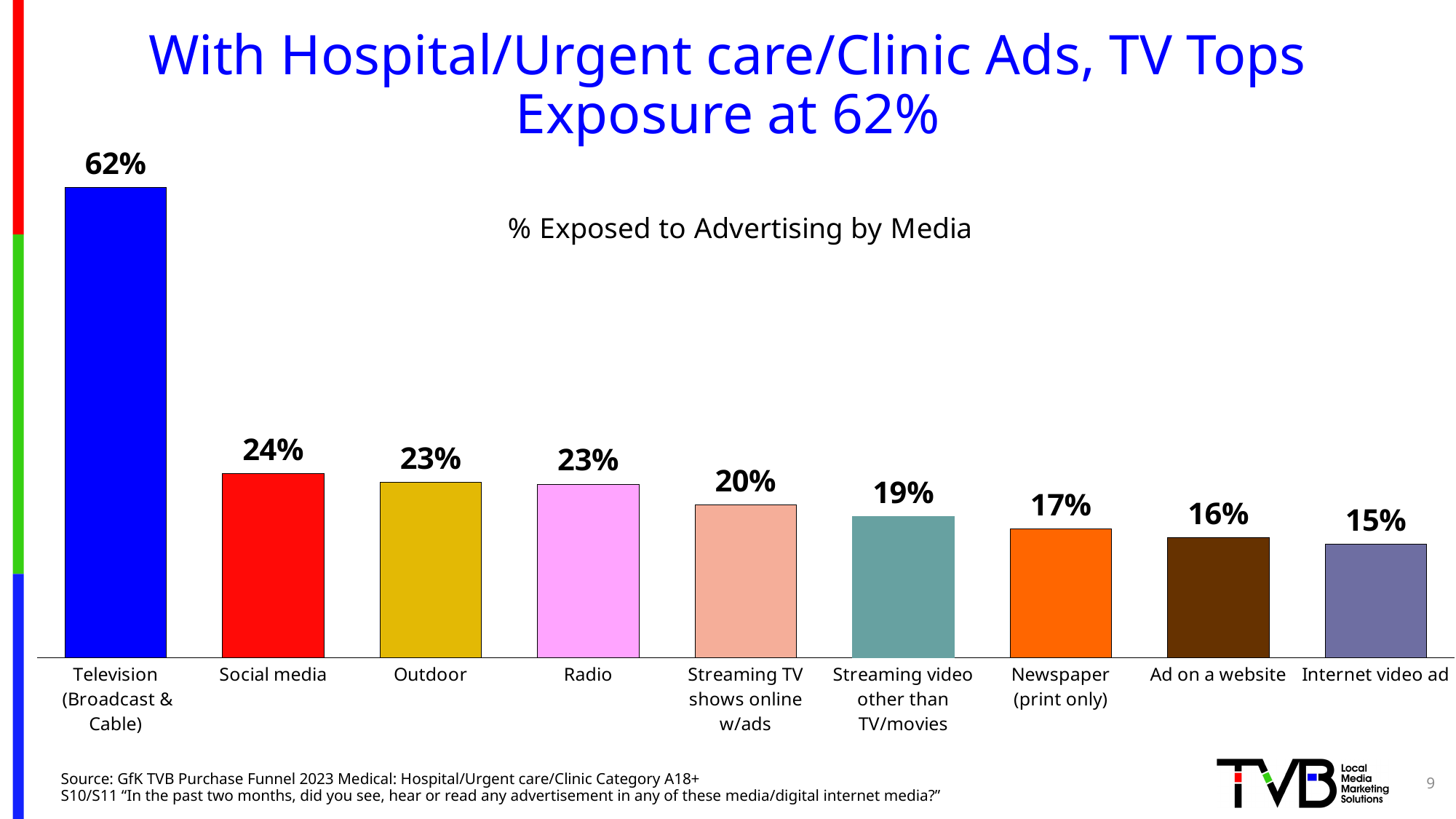
What kind of chart is shown on the slide? Bar chart Which media category has the highest exposure percentage? Television (Broadcast & Cable) What percentage is shown for Television (Broadcast & Cable)? 62% How many media categories are shown in the chart? 9 Which is larger, the value for Radio or the value for Newspaper (print only)? Radio Which media category has the lowest exposure percentage? Internet video ad What is the title of the chart? % Exposed to Advertising by Media What is the difference between the values for Television (Broadcast & Cable) and Social media? 38% What is the value for Social media? 24% What percentage is shown for Streaming TV shows online w/ads? 20% What is the difference between the values for Streaming video other than TV/movies and Ad on a website? 3% What is the value for Newspaper (print only)? 17%